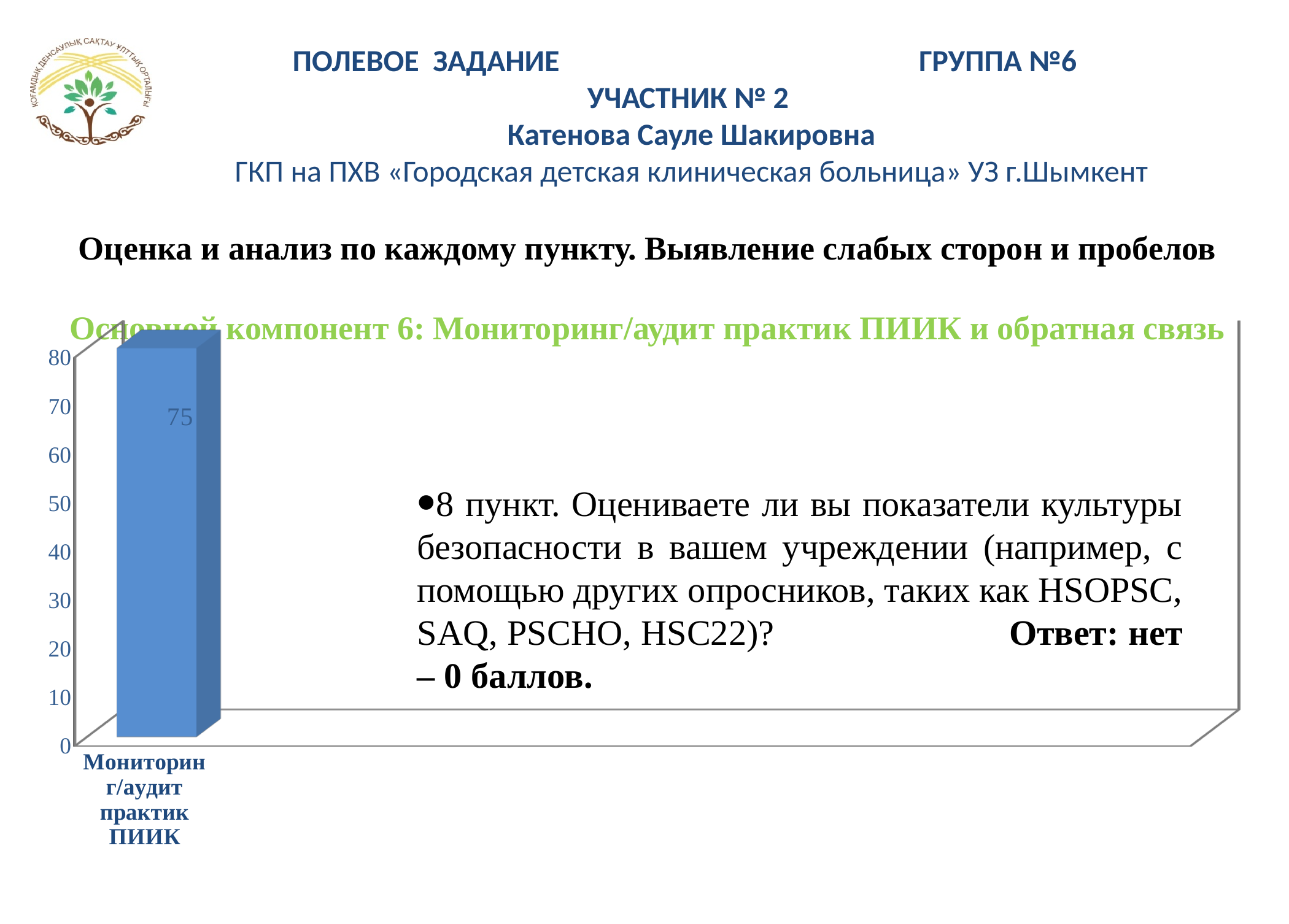
Which category has the highest value in the chart? Мониторинг/аудит практик ПИИК What kind of chart is shown on the slide? bar chart What is the value of the bar for Мониторинг/аудит практик ПИИК? 75 Is the value for Мониторинг/аудит практик ПИИК greater or less than 50? greater What is the category label of the single bar in the chart? Мониторинг/аудит практик ПИИК How many bars are plotted in the chart? 1 What is the highest value shown on the vertical axis of the chart? 80